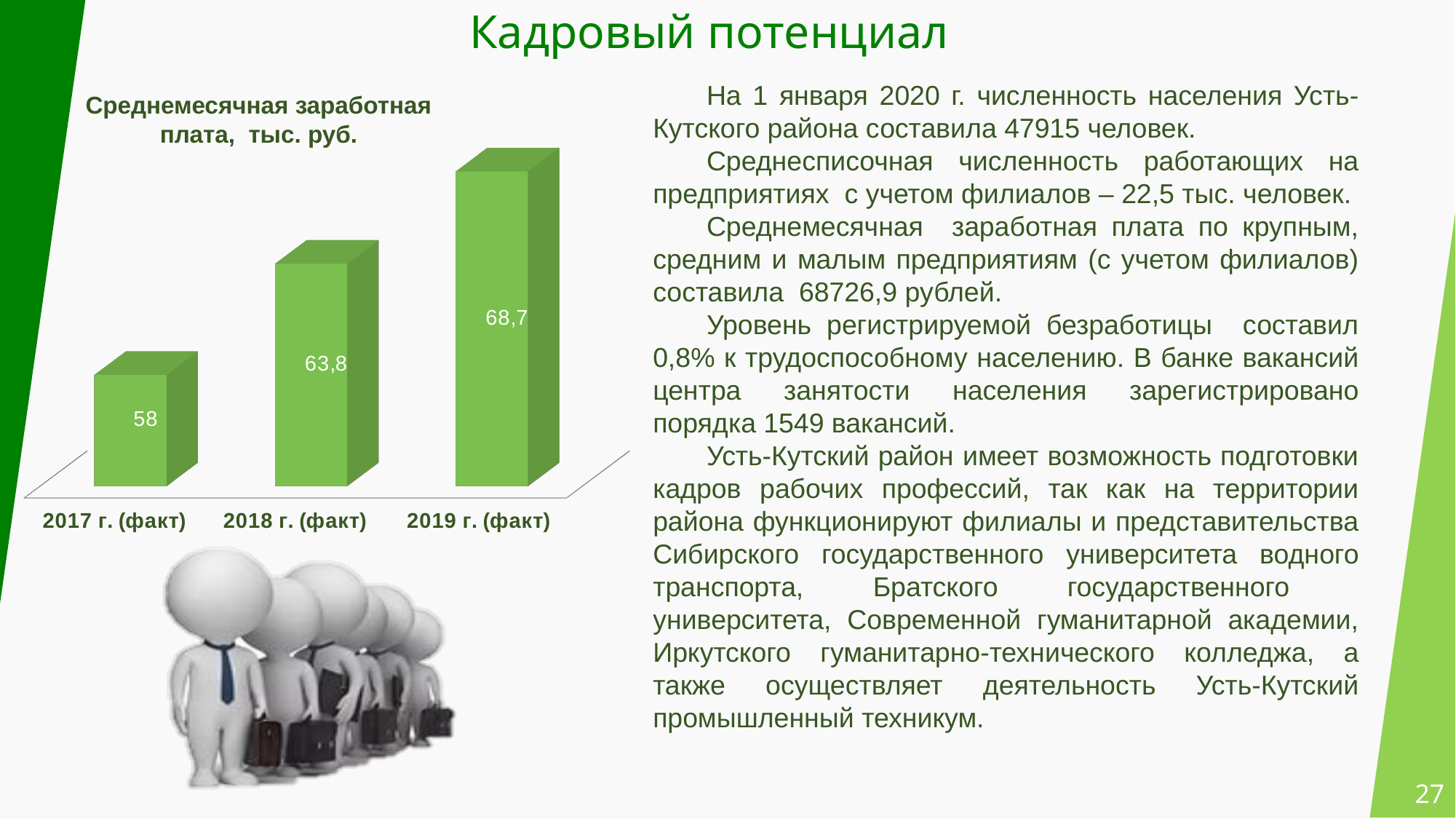
Which is larger, the value for 2018 г. (факт) or 2019 г. (факт)? 2019 г. (факт) How many years (categories) are shown on the chart? 3 What is the difference between the 2019 and 2017 values on the chart? 10,7 What is the title of the chart? Среднемесячная заработная плата, тыс. руб. What is the average monthly salary shown for 2018 г. (факт)? 63,8 What kind of chart is shown on the slide? Bar chart What is the average monthly salary shown for 2017 г. (факт)? 58 Which year has the lowest average monthly salary on the chart? 2017 г. (факт) Which year has the highest average monthly salary on the chart? 2019 г. (факт) What is the average monthly salary shown for 2019 г. (факт)? 68,7 Do the values rise or fall from 2017 to 2019? Rise What is the difference between the 2018 and 2017 values on the chart? 5,8